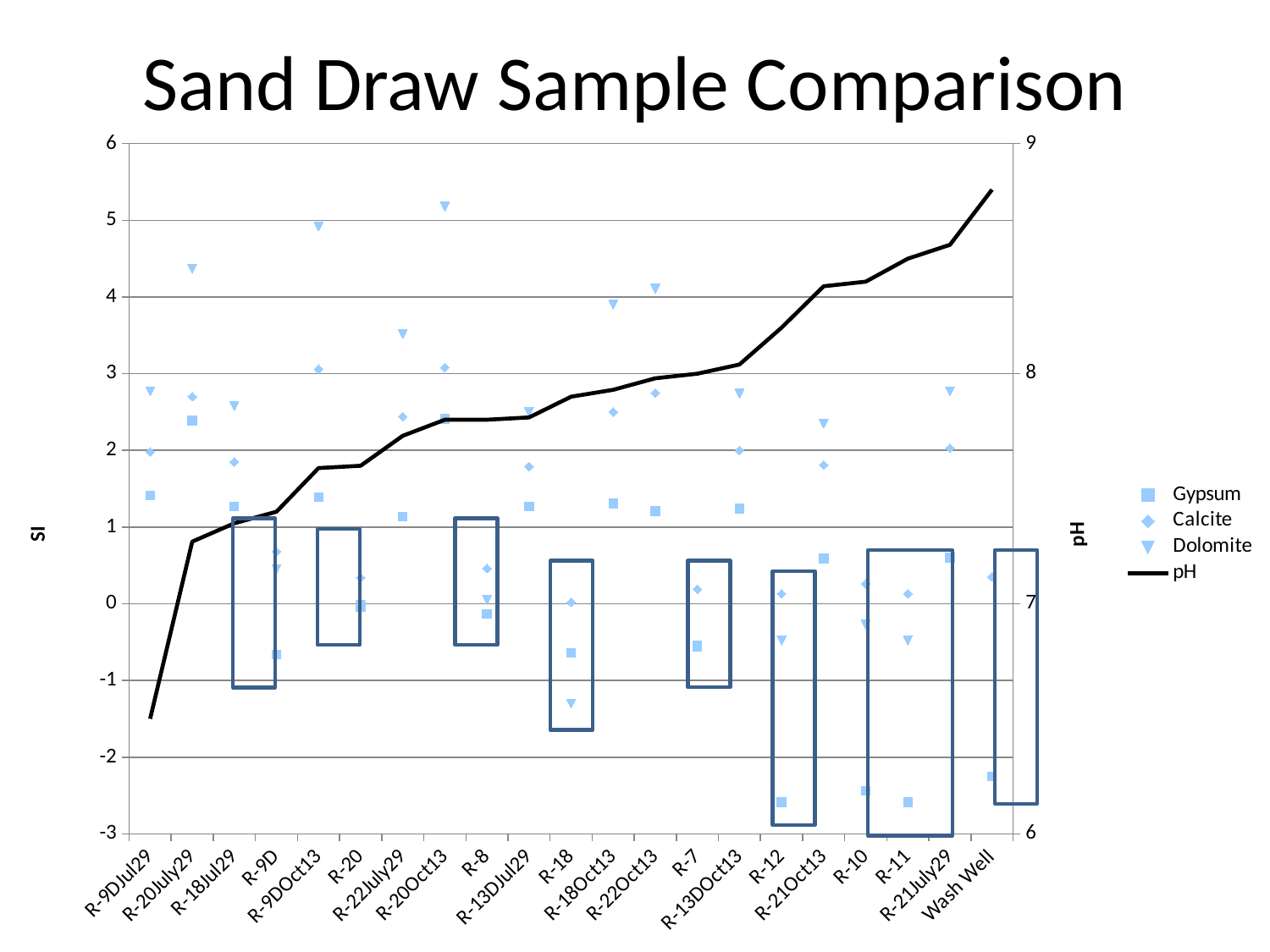
What is the title of the chart? Sand Draw Sample Comparison Which sample has the higher pH, R-10 or R-9D? R-10 Which sample has the highest pH value? Wash Well Is the Dolomite value for R-20July29 greater or less than 4? greater How many series does the legend list? 4 What is the label of the right-hand vertical axis? pH Which sample has the highest Dolomite SI value? R-20Oct13 Is the pH value for Wash Well greater or less than 8? greater Which sample has the lowest pH value? R-9DJul29 How many sample categories are shown along the x axis? 21 Does the pH line rise or fall from left to right along the x axis? rise Is the Gypsum value for R-12 greater or less than -2? less